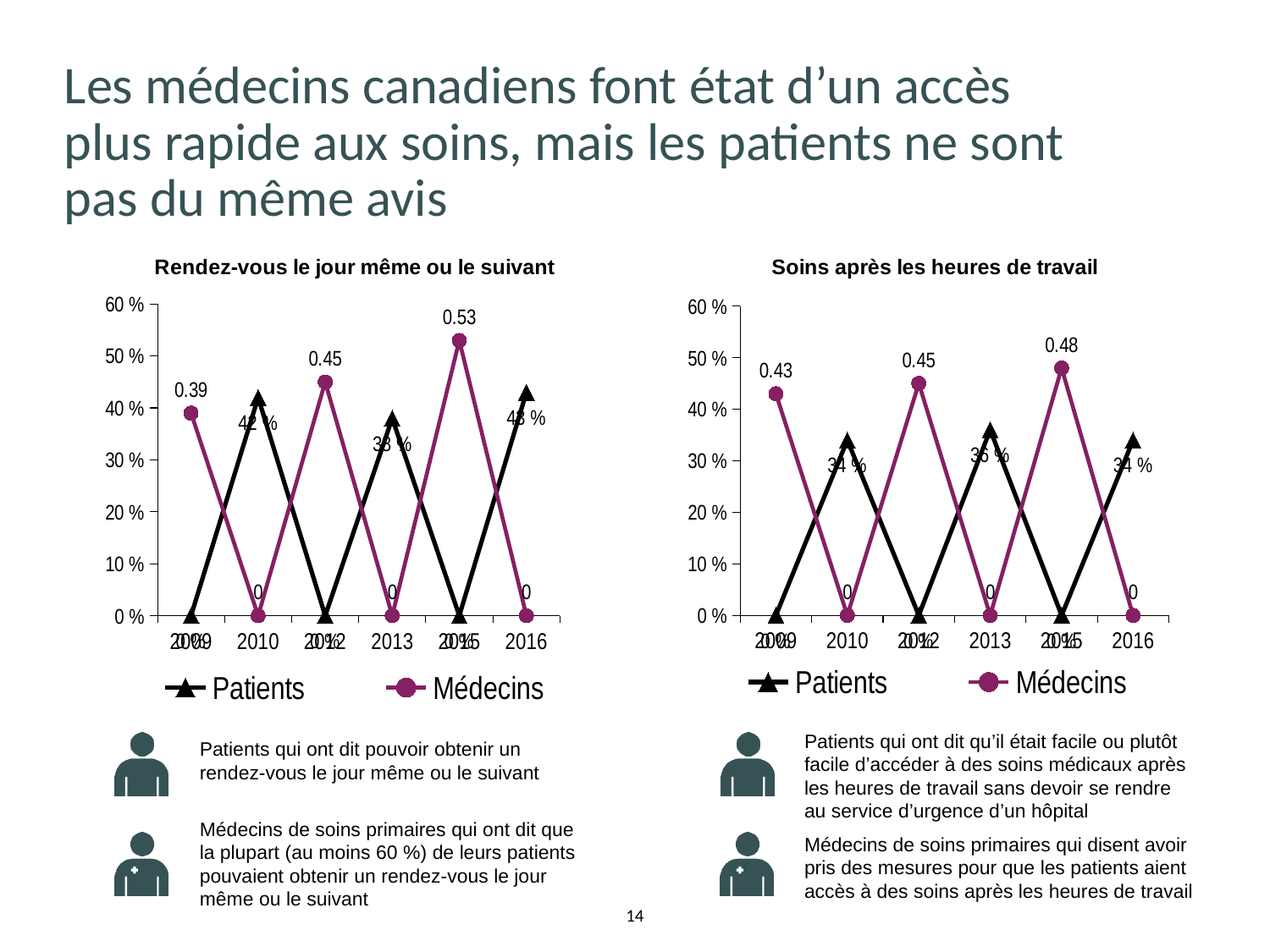
What are the two legend entries in the 'Rendez-vous le jour même ou le suivant' chart? Patients, Médecins In the 'Rendez-vous le jour même ou le suivant' chart, is the Patients value for 2016 greater or less than 40 %? greater In the 'Soins après les heures de travail' chart, what is the Médecins value for 2015? 0.48 What kind of chart is the 'Rendez-vous le jour même ou le suivant' chart? line chart In the 'Soins après les heures de travail' chart, do the Médecins values rise or fall from 2009 to 2015? rise In the 'Rendez-vous le jour même ou le suivant' chart, what is the Médecins value for 2015? 0.53 In the 'Soins après les heures de travail' chart, what is the difference between the Médecins values for 2015 and 2009? 0.05 In the 'Rendez-vous le jour même ou le suivant' chart, which is larger: the Médecins value for 2012 or for 2015? 2015 In the 'Rendez-vous le jour même ou le suivant' chart, in which year is the Médecins value highest? 2015 In the 'Soins après les heures de travail' chart, what is the Médecins value for 2009? 0.43 In the 'Rendez-vous le jour même ou le suivant' chart, what is the difference between the Médecins values for 2015 and 2009? 0.14 How many series does the legend of the 'Soins après les heures de travail' chart list? 2